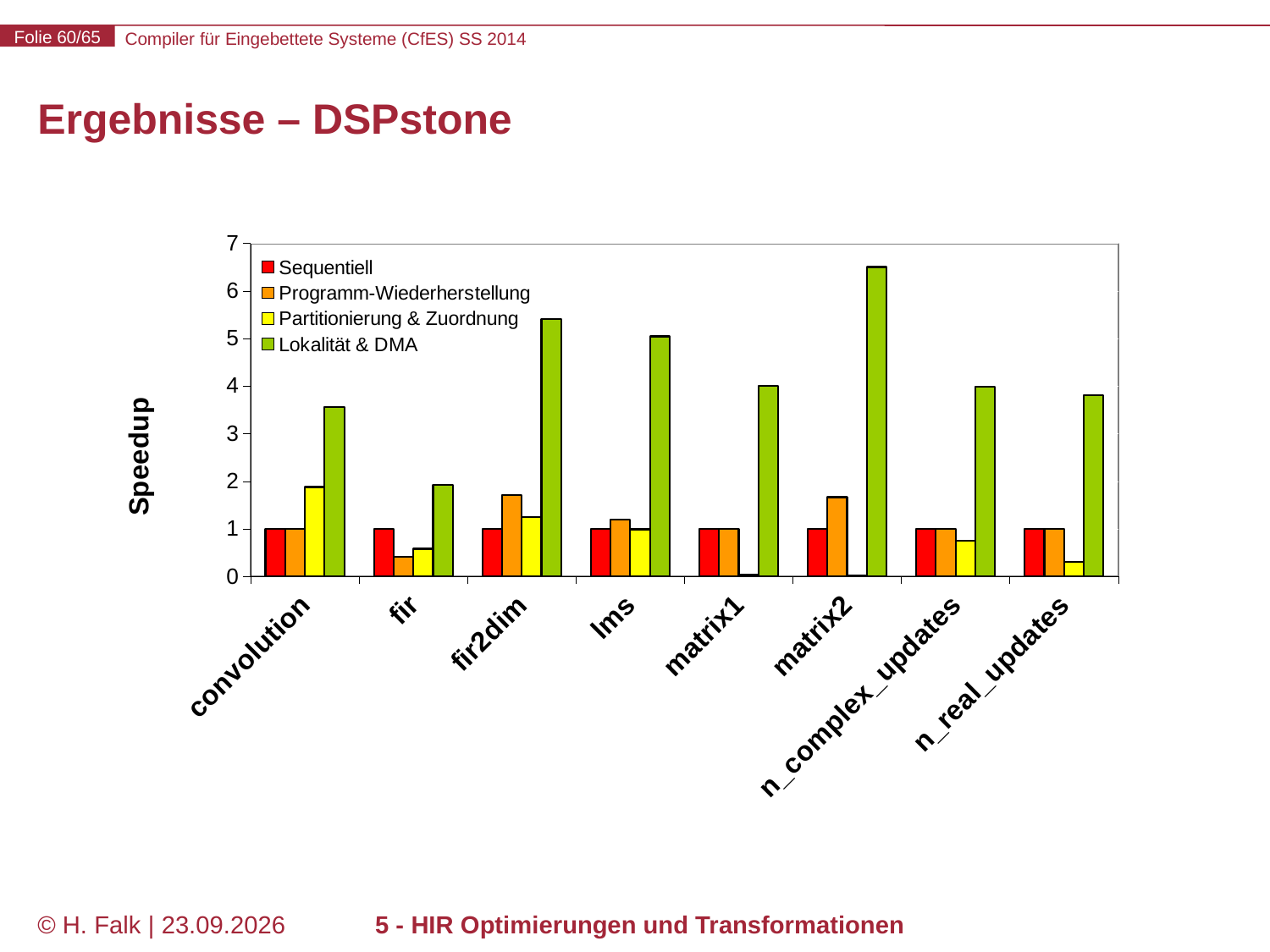
Is the Programm-Wiederherstellung value for fir greater or less than 1? less What is the Speedup value of the Sequentiell series for matrix2? 1 Which benchmark has the highest Lokalität & DMA speedup? matrix2 How many series does the legend list? 4 Which has the larger Lokalität & DMA speedup, convolution or fir? convolution How many benchmark categories are shown on the x axis? 8 What kind of chart is shown on the slide? bar chart What is the Speedup value of the Sequentiell series for convolution? 1 Is the Lokalität & DMA value for matrix2 greater or less than 6? greater Is the Lokalität & DMA value for convolution greater or less than 3? greater What is the label of the y axis? Speedup Which benchmark has the lowest Lokalität & DMA speedup? fir